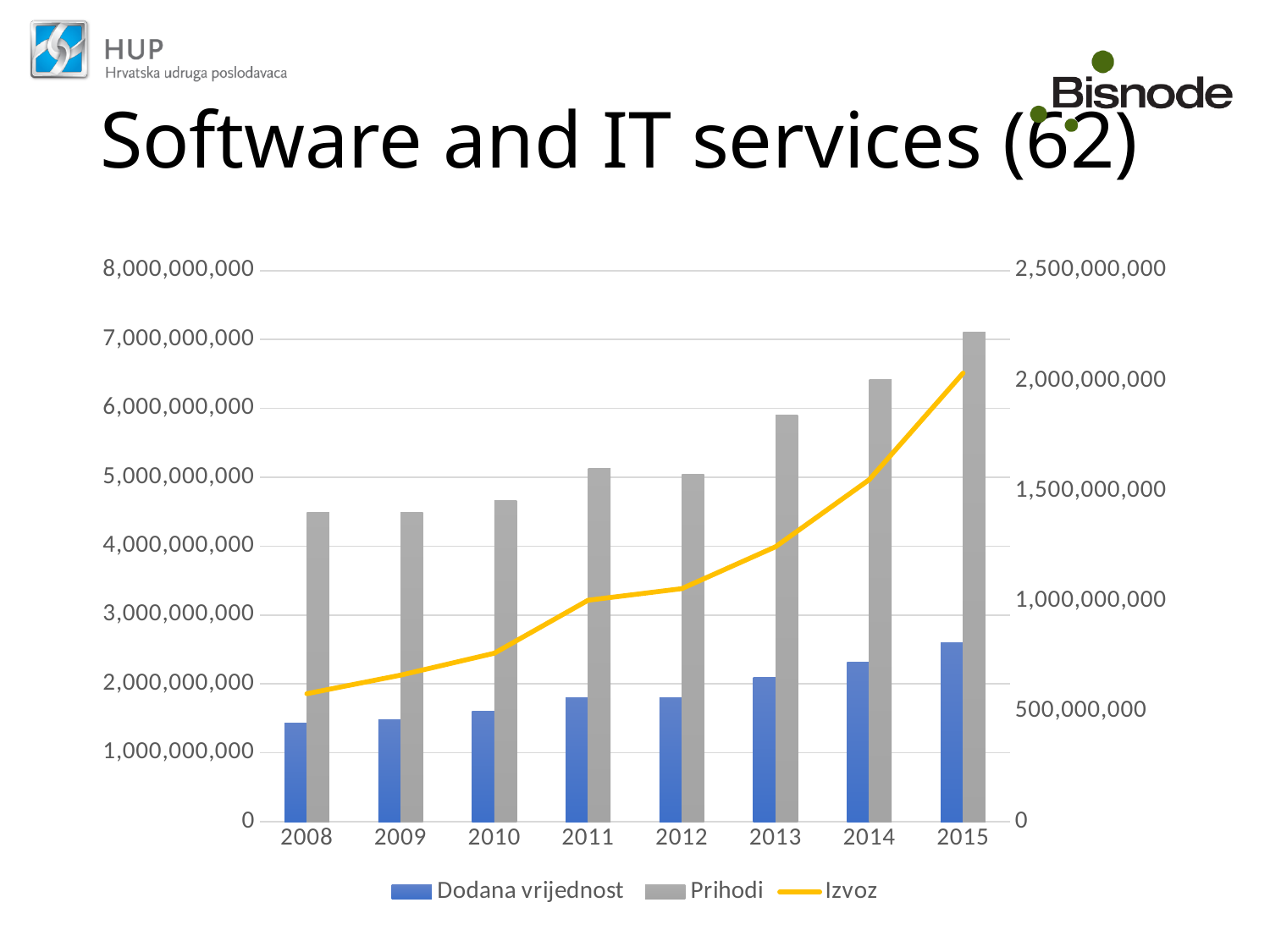
In which year is Izvoz lowest? 2008 How many years are shown on the x axis of the chart? 8 In which year is Prihodi highest? 2015 Is the value of Izvoz for 2013 greater or less than 1,000,000,000 on the right axis? greater How many series does the chart legend list? 3 Which is larger, Prihodi in 2012 or Prihodi in 2014? Prihodi in 2014 Does Izvoz rise or fall from 2008 to 2015? Rises In which year is Dodana vrijednost highest? 2015 Is the value of Dodana vrijednost for 2015 greater or less than 2,000,000,000? greater What kind of chart is shown on the slide? A combined bar and line chart Which series is drawn as a line rather than bars? Izvoz Is the value of Prihodi for 2014 greater or less than 6,000,000,000? greater